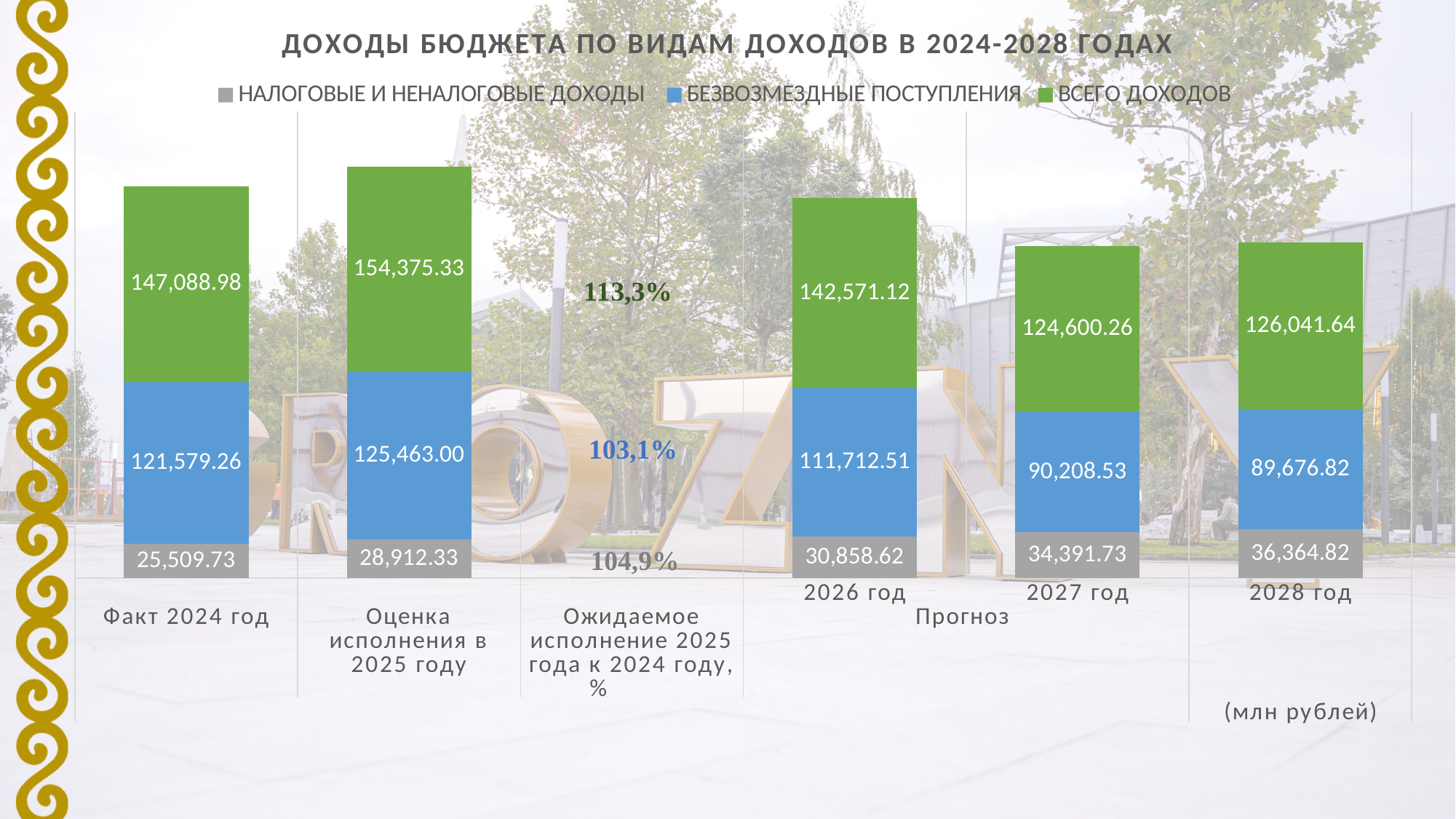
What is the difference in ВСЕГО ДОХОДОВ between Оценка исполнения в 2025 году and Факт 2024 год? 7,286.35 Which category has the highest value of ВСЕГО ДОХОДОВ? Оценка исполнения в 2025 году What is the difference in НАЛОГОВЫЕ И НЕНАЛОГОВЫЕ ДОХОДЫ between 2028 год and 2027 год? 1,973.09 What is the value of ВСЕГО ДОХОДОВ for Оценка исполнения в 2025 году? 154,375.33 What kind of chart is shown on the slide? Stacked bar chart How many series does the legend list? 3 Which category has the lowest value of ВСЕГО ДОХОДОВ? 2027 год What is the value of НАЛОГОВЫЕ И НЕНАЛОГОВЫЕ ДОХОДЫ for Факт 2024 год? 25,509.73 What is the value of БЕЗВОЗМЕЗДНЫЕ ПОСТУПЛЕНИЯ for 2027 год? 90,208.53 Which is larger for БЕЗВОЗМЕЗДНЫЕ ПОСТУПЛЕНИЯ: 2026 год or 2028 год? 2026 год Do the values of НАЛОГОВЫЕ И НЕНАЛОГОВЫЕ ДОХОДЫ rise or fall from 2026 год to 2028 год? Rise